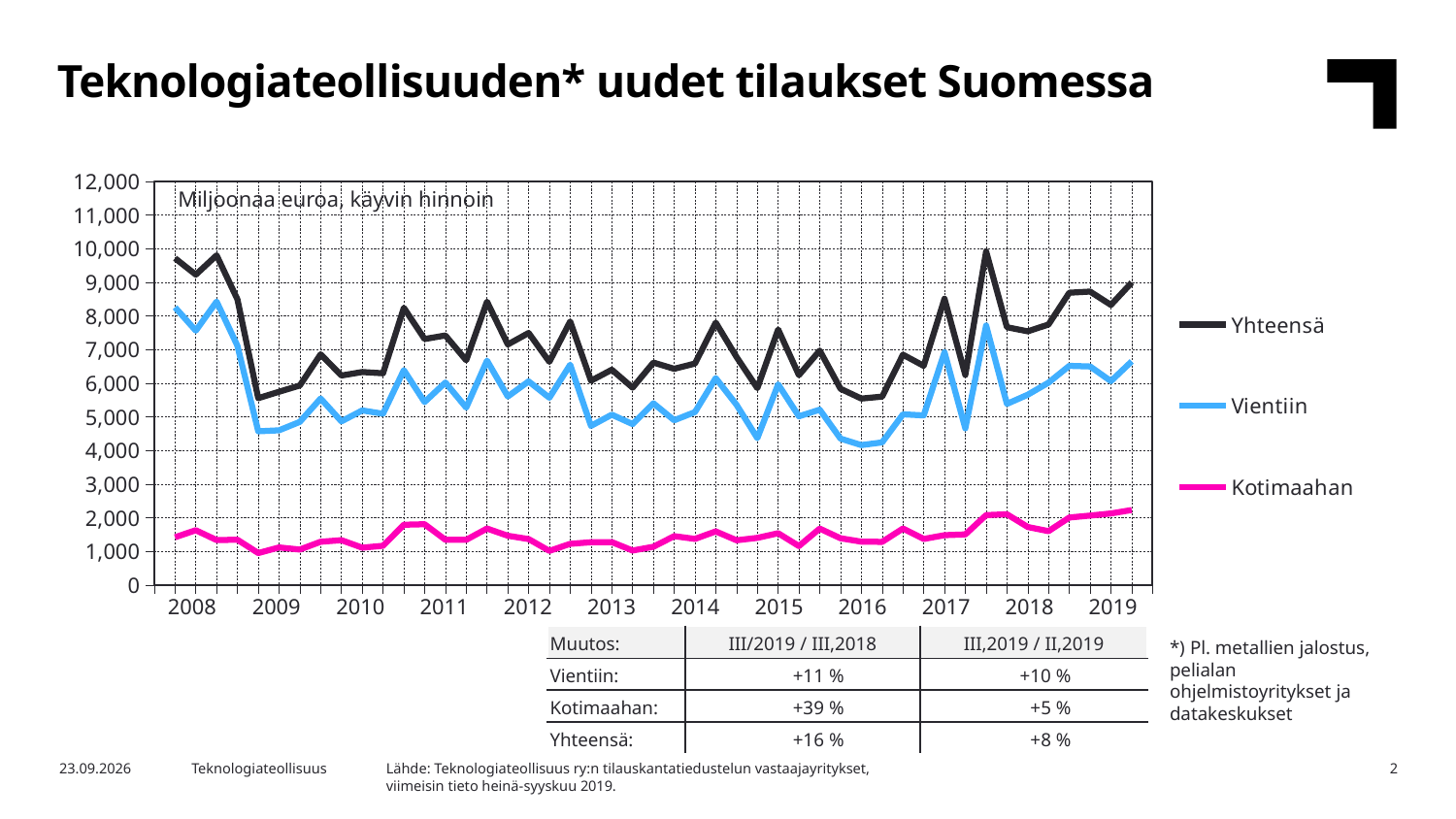
Which series has the lowest values throughout the whole period? Kotimaahan How many year labels are shown on the x axis? 12 Is the lowest value for Vientiin in 2016 greater or less than 5,000? less What are the three series named in the chart legend? Yhteensä, Vientiin, Kotimaahan Which series has the highest values throughout the whole period? Yhteensä What unit label is printed inside the chart area? Miljoonaa euroa, käyvin hinnoin How many series does the chart legend list? 3 Is the first value for Yhteensä in 2008 greater or less than 9,000? greater Does the Yhteensä line rise or fall from the start of 2008 to the start of 2009? Fall What kind of chart is shown on the slide? Line chart Which is larger in 2019, the value for Vientiin or the value for Kotimaahan? Vientiin Is the value for Kotimaahan in 2019 greater or less than 3,000? less